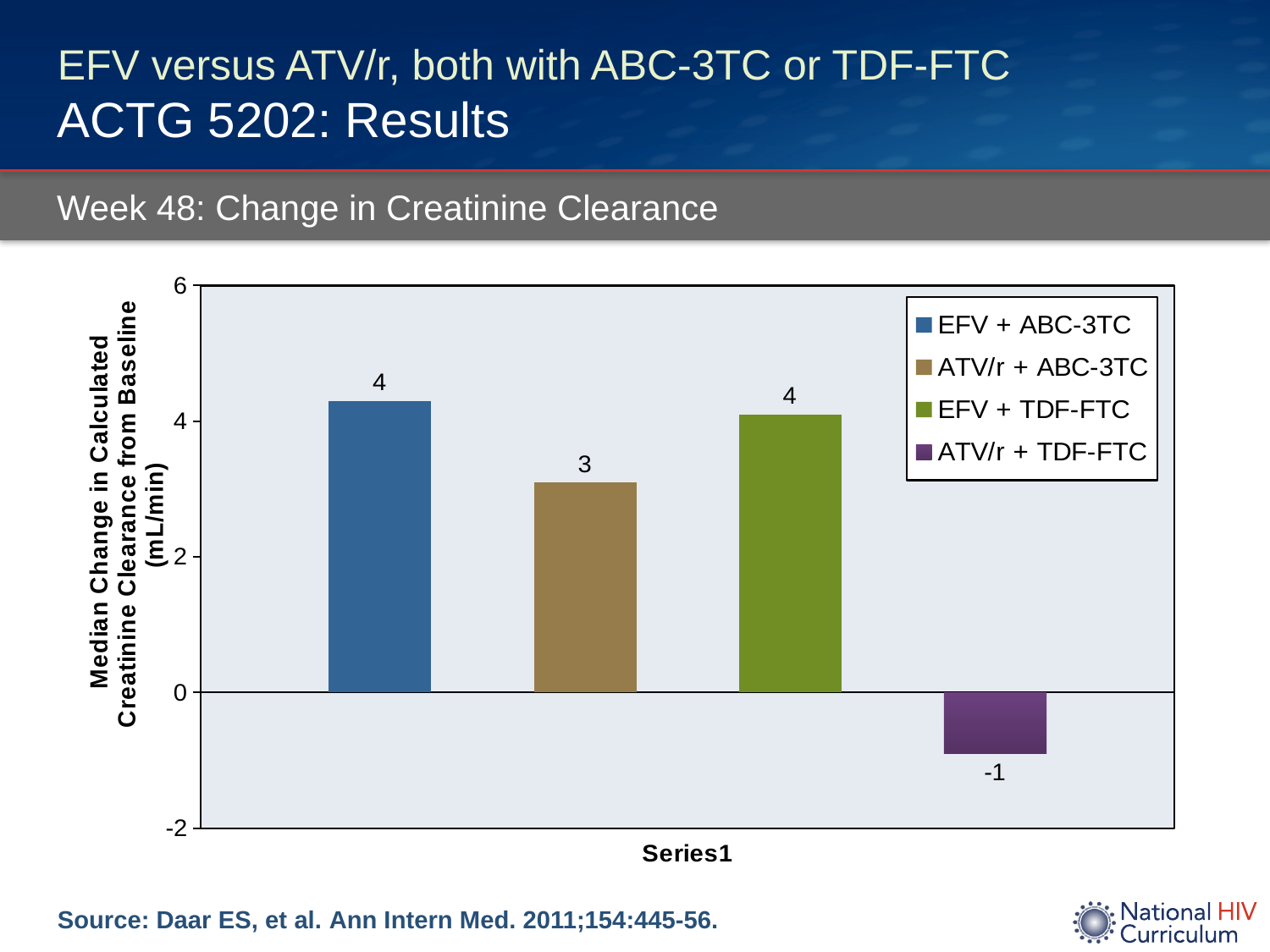
What is the difference between the values for ATV/r + ABC-3TC and ATV/r + TDF-FTC? 4 What kind of chart is shown on the slide? Bar chart How many bars are plotted in the chart? 4 Is the value for ATV/r + TDF-FTC greater or less than 0? less What is the median change in calculated creatinine clearance for EFV + ABC-3TC? 4 What is the median change in calculated creatinine clearance for ATV/r + ABC-3TC? 3 What is the difference between the values for EFV + ABC-3TC and ATV/r + ABC-3TC? 1 Which has the larger median change in creatinine clearance, EFV + TDF-FTC or ATV/r + TDF-FTC? EFV + TDF-FTC Which regimen has the lowest median change in creatinine clearance? ATV/r + TDF-FTC How many entries does the legend list? 4 What is the median change in calculated creatinine clearance for ATV/r + TDF-FTC? -1 Is the value for ATV/r + ABC-3TC greater or less than 2? greater